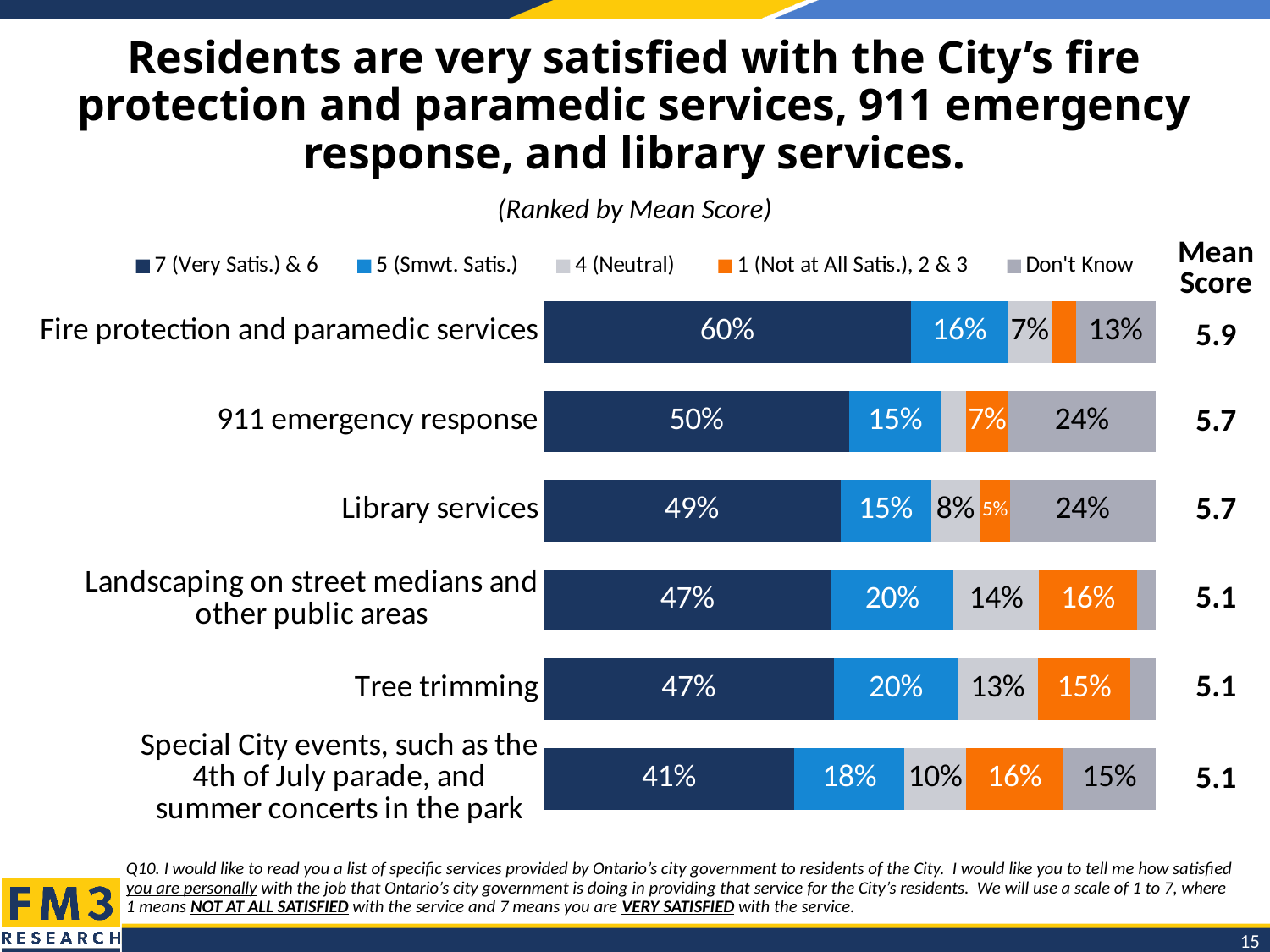
What is the difference in the 7 (Very Satis.) & 6 share between fire protection and paramedic services and special City events? 19 percentage points What percentage of residents rated tree trimming 5 (Smwt. Satis.)? 20% How many services are shown in the chart? 6 How many series does the legend list? 5 Which has a larger 7 (Very Satis.) & 6 share: fire protection and paramedic services or 911 emergency response? Fire protection and paramedic services What is the mean score for 911 emergency response? 5.7 What percentage of residents rated fire protection and paramedic services 7 (Very Satis.) & 6? 60% What is the total of the segments in the bar for special City events, such as the 4th of July parade, and summer concerts in the park? 100% What type of chart is shown on the slide? Stacked bar chart Which service has the lowest share of 7 (Very Satis.) & 6 ratings? Special City events, such as the 4th of July parade, and summer concerts in the park Which service has the highest share of 7 (Very Satis.) & 6 ratings? Fire protection and paramedic services What is the Don't Know percentage for library services? 24%